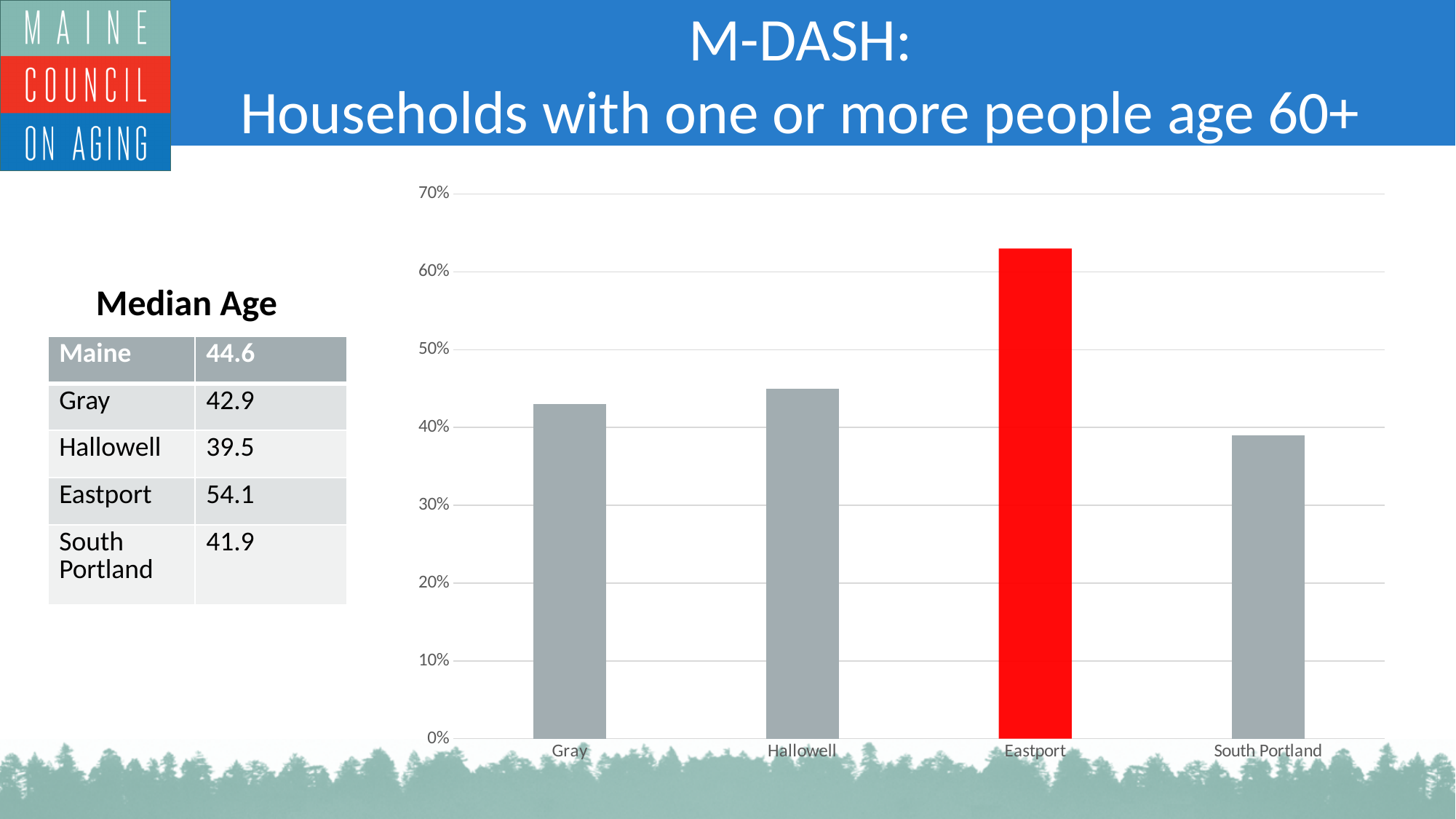
What kind of chart is shown on the slide? bar chart Is the value for Gray greater or less than 40%? greater Which town has the lowest share of households with one or more people age 60+? South Portland How many towns are plotted in the bar chart? 4 Is the value for Hallowell greater or less than 50%? less Which has a larger share of households with one or more people age 60+, Hallowell or South Portland? Hallowell Which town has the highest share of households with one or more people age 60+? Eastport What is the highest value shown on the chart's vertical axis? 70% Which has a larger share of households with one or more people age 60+, Eastport or Gray? Eastport Is the value for Eastport greater or less than 60%? greater Which town's bar is coloured red in the chart? Eastport